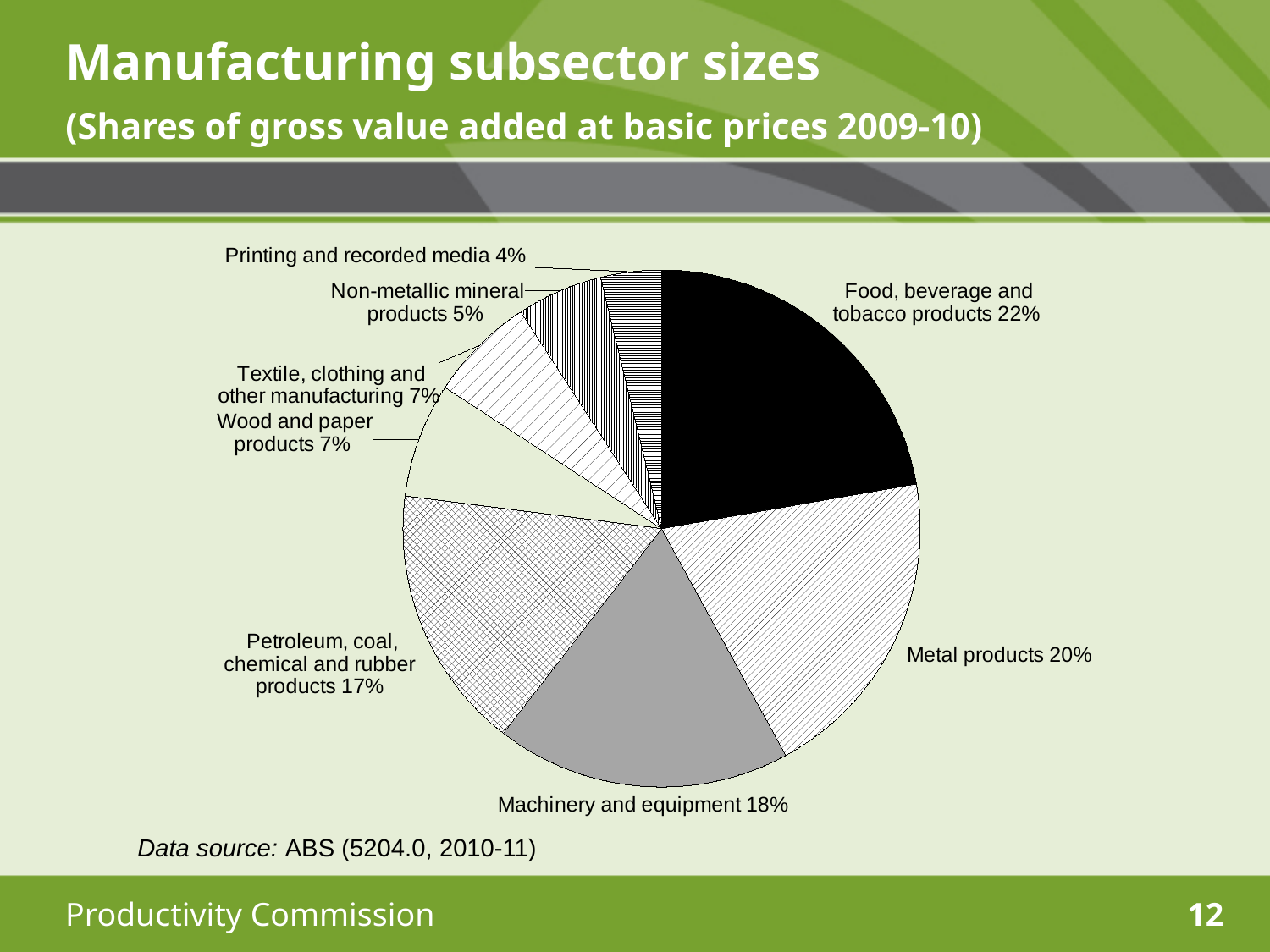
How many subsectors (slices) are shown in the pie chart? 8 What kind of chart is shown on the slide? Pie chart What share does Petroleum, coal, chemical and rubber products have? 17% What share does Metal products have? 20% Which is larger, the share for Machinery and equipment or the share for Petroleum, coal, chemical and rubber products? Machinery and equipment What share does Printing and recorded media have? 4% Which subsector has the largest share of the pie? Food, beverage and tobacco products What share does Machinery and equipment have? 18% What is the subtitle of the chart shown on the slide? Shares of gross value added at basic prices 2009-10 Which subsector has the smallest share of the pie? Printing and recorded media What share does Food, beverage and tobacco products have? 22% What is the difference in percentage points between Food, beverage and tobacco products and Metal products? 2